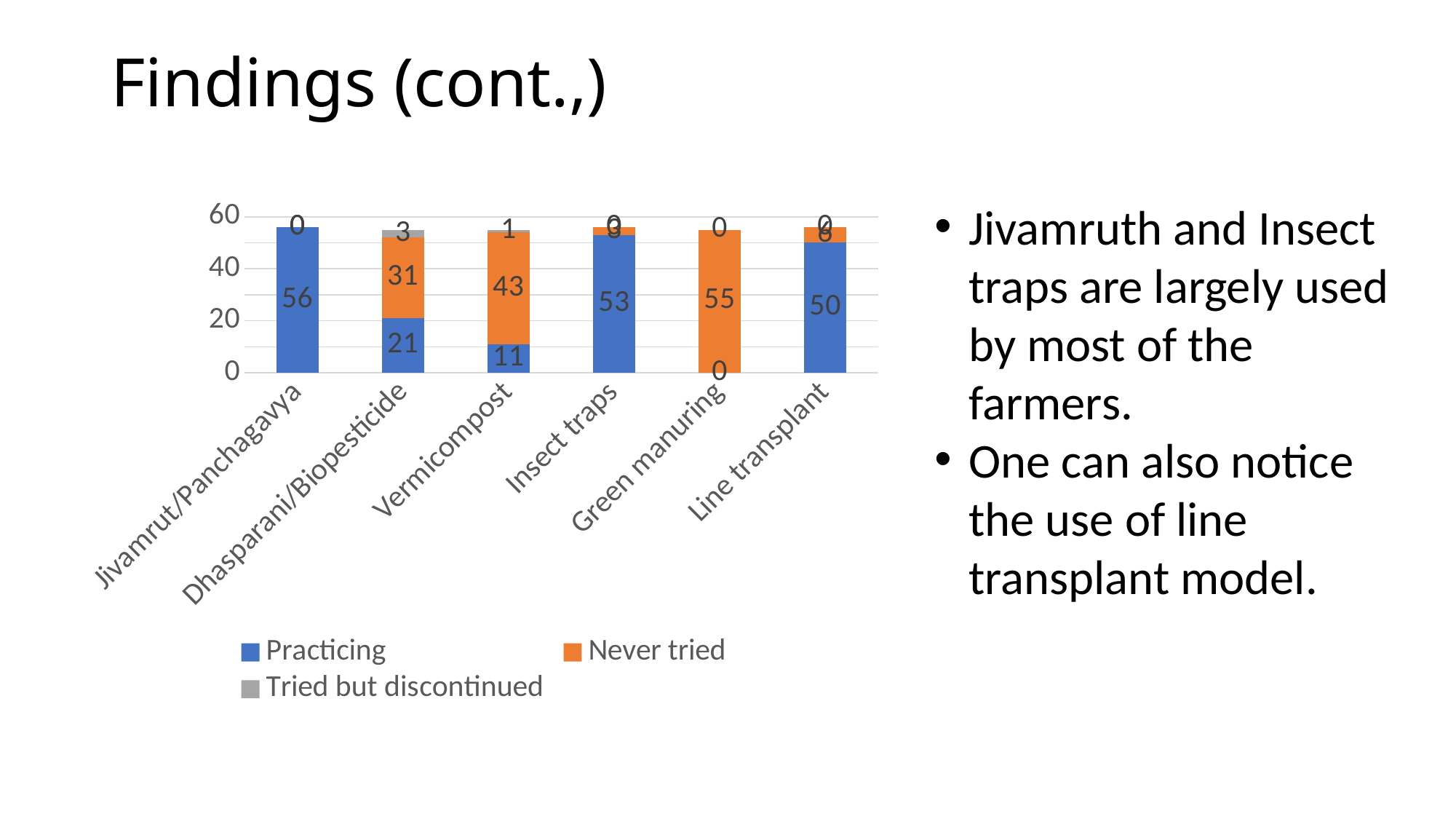
What is the Never tried value for Green manuring? 55 What is the total of the stacked bar for Dhasparani/Biopesticide? 55 Which category has the highest Practicing value? Jivamrut/Panchagavya Which has the larger Practicing value, Insect traps or Line transplant? Insect traps What is the Practicing value for Dhasparani/Biopesticide? 21 How many categories are shown on the x axis of the chart? 6 What is the difference between the Never tried values for Vermicompost and Dhasparani/Biopesticide? 12 What is the Tried but discontinued value for Dhasparani/Biopesticide? 3 What kind of chart is shown on the slide? Stacked bar chart What is the Never tried value for Vermicompost? 43 How many series does the chart's legend list? 3 What is the Practicing value for Jivamrut/Panchagavya? 56